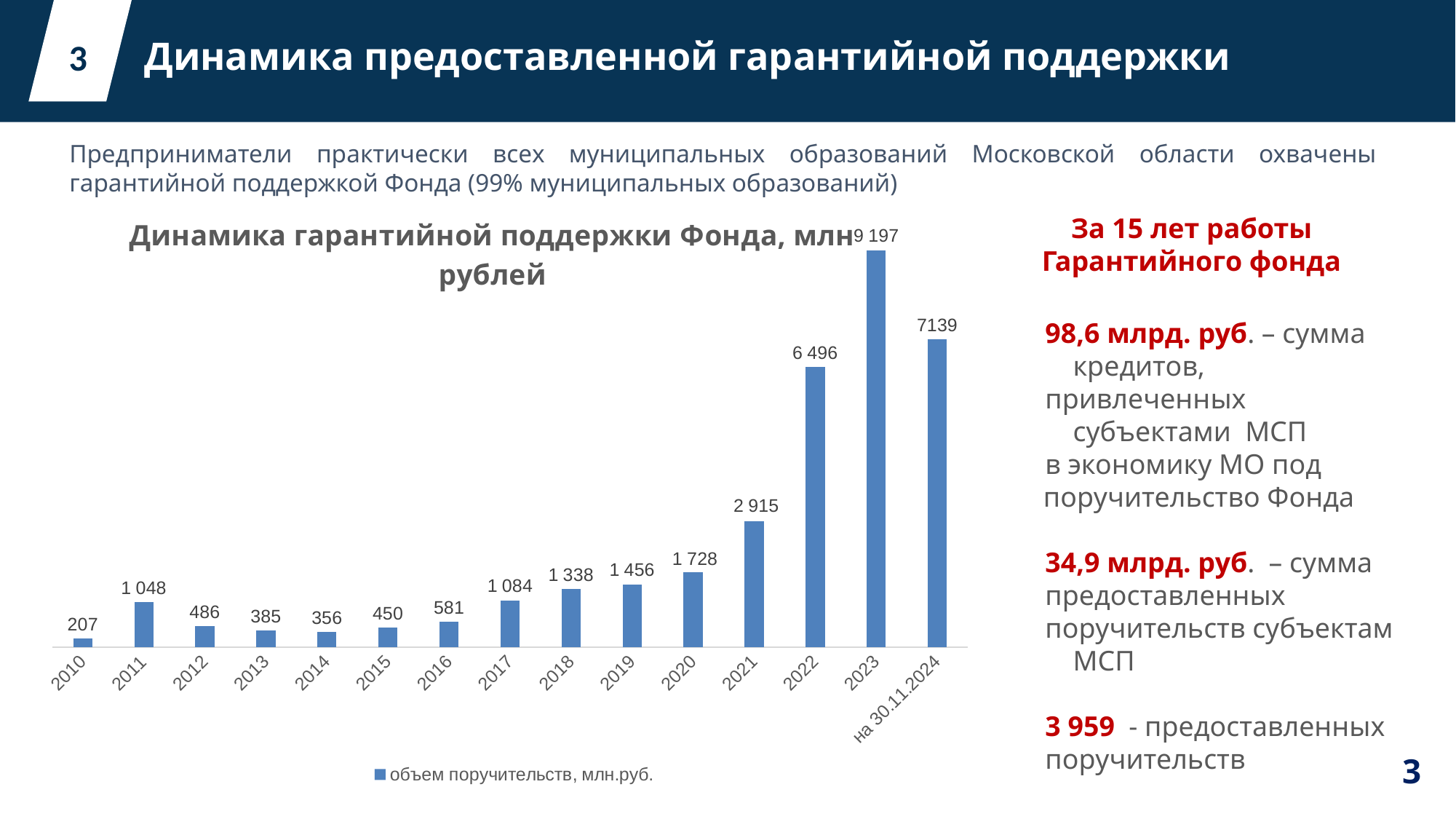
How many series does the legend list? 1 What is the value for 2010 in the chart? 207 Which is larger, the value for 2011 or the value for 2017? 2017 What is the value for на 30.11.2024 in the chart? 7139 What kind of chart is shown on the slide? Bar chart What is the value for 2021 in the chart? 2 915 Which year has the lowest value in the chart? 2010 What is the value for 2023 in the chart? 9 197 Which year has the highest value in the chart? 2023 What is the difference between the values for 2023 and 2022? 2 701 What is the legend entry of the chart? объем поручительств, млн.руб. How many bars are shown in the chart? 15